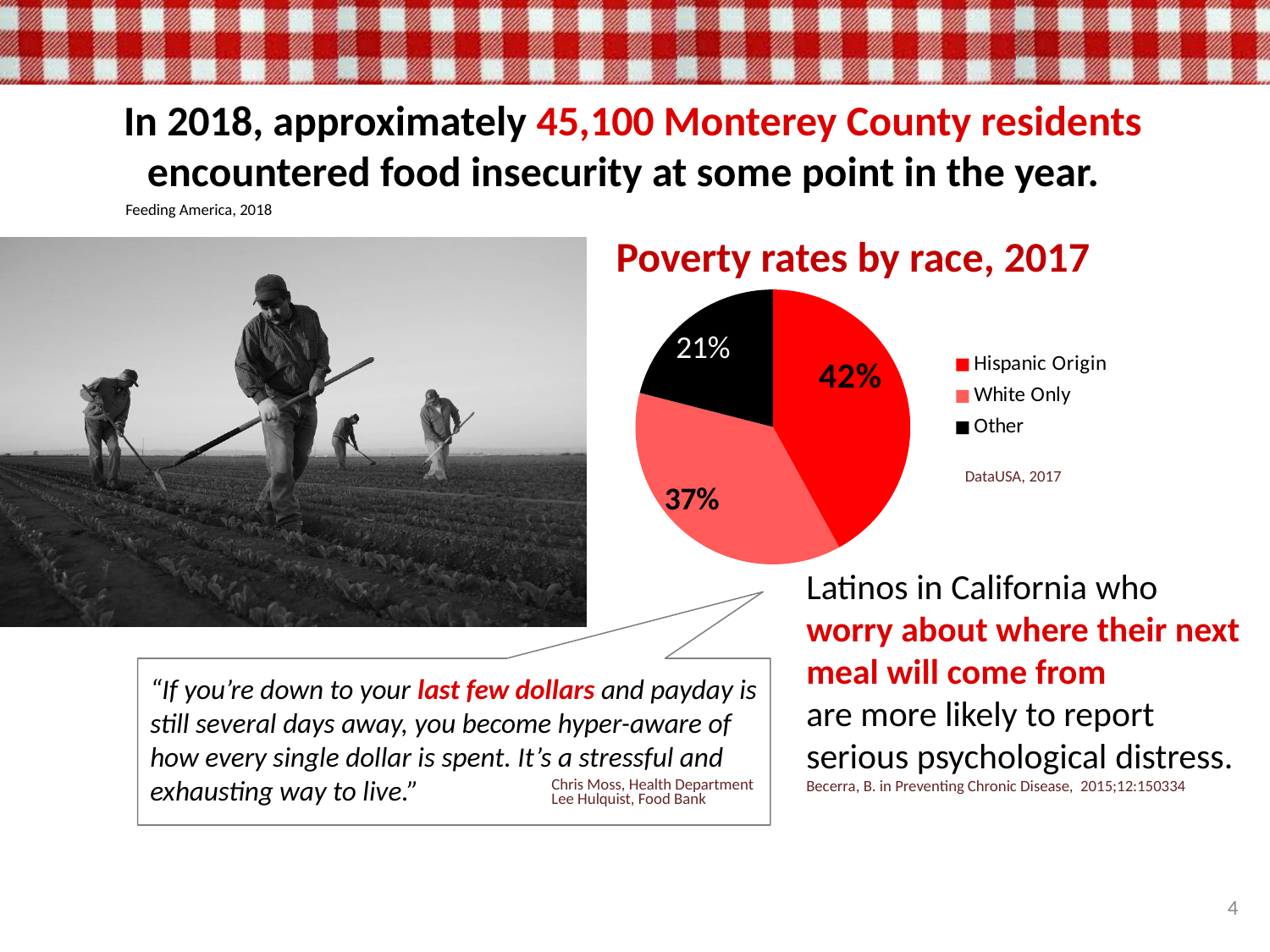
What is the value for Other in the pie chart? 21% What type of chart is shown on the slide? pie chart Which category has the largest share of the pie chart? Hispanic Origin How many categories does the pie chart show? 3 Which category has the smallest share of the pie chart? Other What is the title of the chart? Poverty rates by race, 2017 What is the difference between the Hispanic Origin and White Only shares? 5% What is the value for Hispanic Origin in the pie chart? 42% Which is larger, the share for White Only or the share for Other? White Only What is the difference between the White Only and Other shares? 16% What is the value for White Only in the pie chart? 37% What colour is the Other slice in the pie chart? black